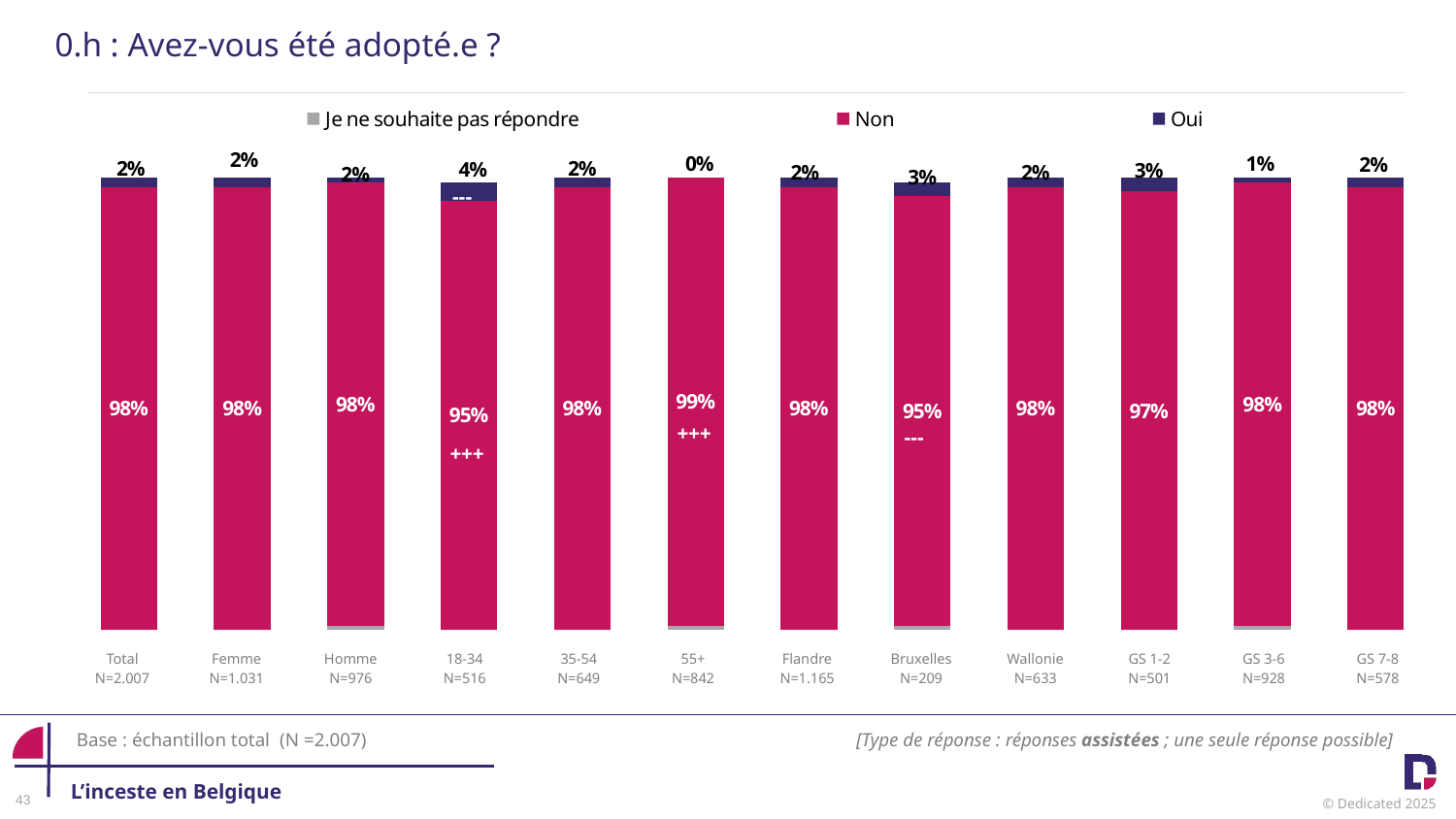
What is the 'Non' value for GS 1-2? 97% What is the difference between the 'Non' values for Total and Bruxelles? 3% How many series does the legend list? 3 What is the 'Oui' value for the 55+ category? 0% What is the 'Non' value for the 18-34 category? 95% Which category has the highest 'Non' value? 55+ Is the 'Oui' value larger for 18-34 or for GS 3-6? 18-34 Which category has the highest 'Oui' value? 18-34 What kind of chart is shown on the slide? Stacked bar chart Which category has the lowest 'Oui' value? 55+ How many categories are shown on the x axis? 12 What is the 'Oui' value for the Bruxelles category? 3%